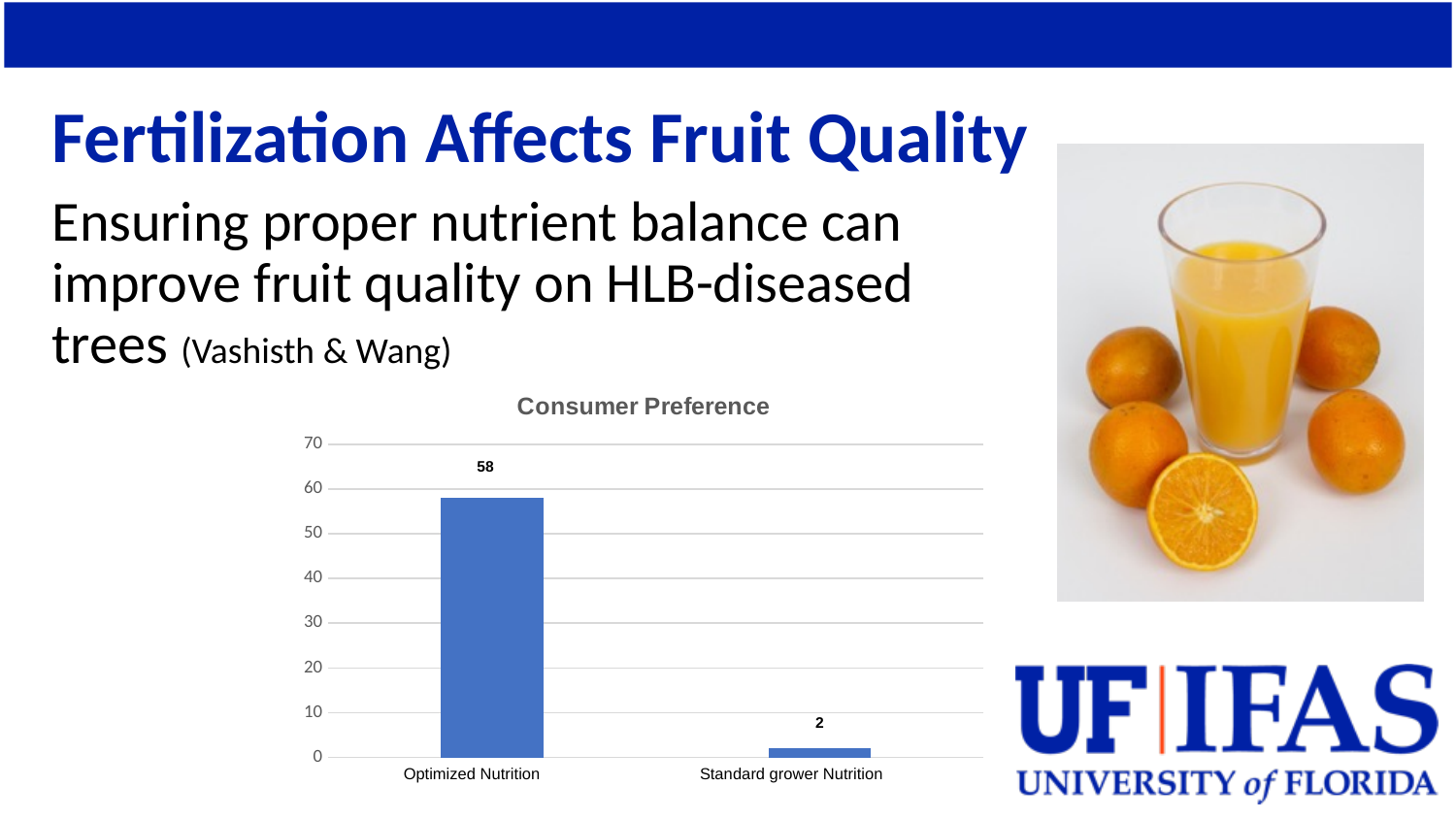
What is the value for Standard grower Nutrition in the Consumer Preference chart? 2 Is the value for Standard grower Nutrition greater or less than 10? less Is the value for Optimized Nutrition greater or less than 50? greater Which category has the lowest value in the Consumer Preference chart? Standard grower Nutrition What is the highest value shown on the y axis of the Consumer Preference chart? 70 What is the value for Optimized Nutrition in the Consumer Preference chart? 58 Which is larger, the value for Optimized Nutrition or the value for Standard grower Nutrition? Optimized Nutrition What kind of chart is shown on the slide? Bar chart What is the title of the chart on the slide? Consumer Preference How many categories are shown in the Consumer Preference chart? 2 What is the difference between the values for Optimized Nutrition and Standard grower Nutrition? 56 Which category has the highest value in the Consumer Preference chart? Optimized Nutrition